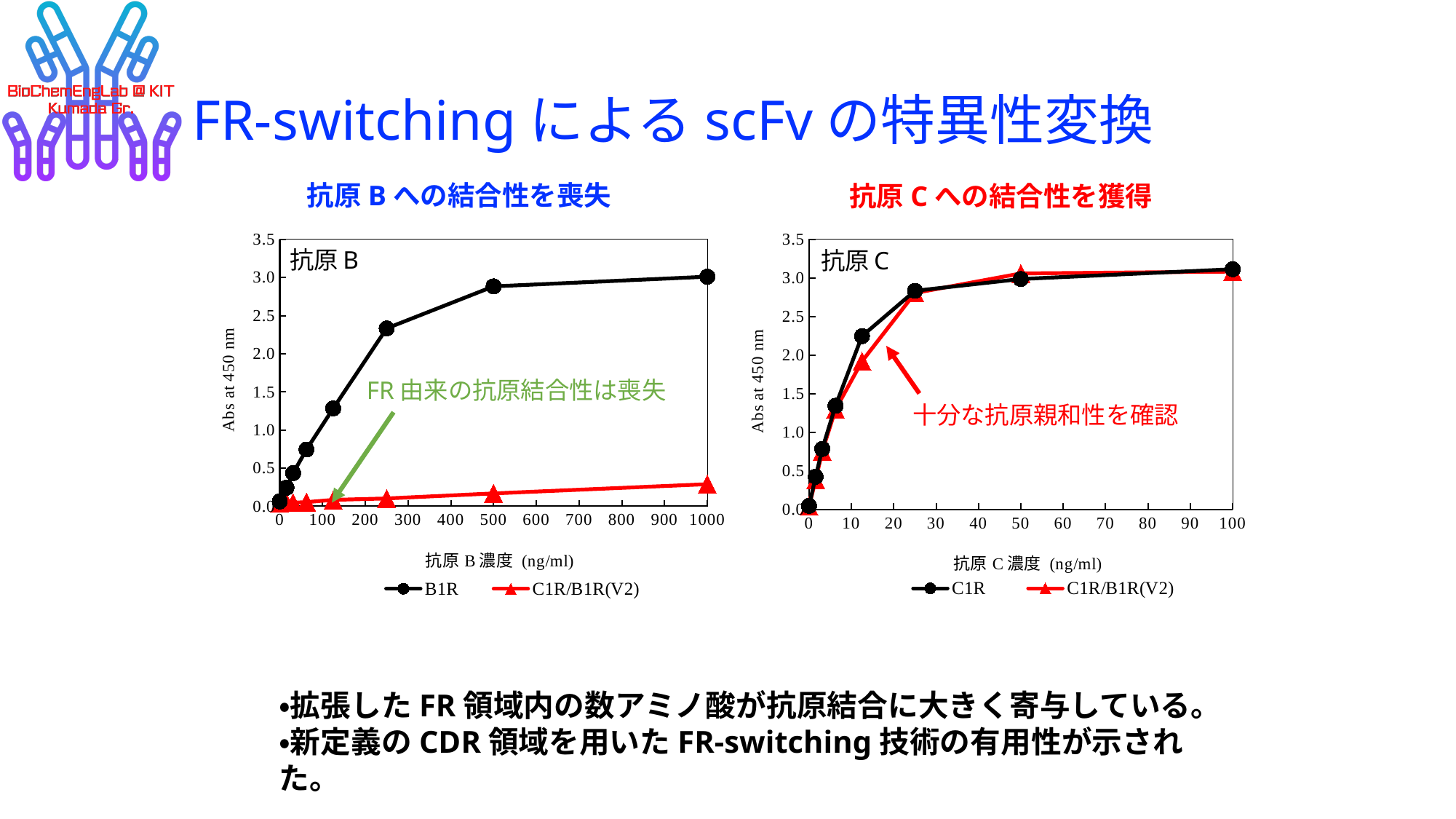
What are the two legend entries of the left chart (抗原 B)? B1R and C1R/B1R(V2) In the left chart (抗原 B), which series has the larger value at 1000 ng/ml, B1R or C1R/B1R(V2)? B1R In the left chart (抗原 B), is the value for B1R at 1000 ng/ml greater or less than 2.5? greater In the left chart (抗原 B), is the value for B1R at 250 ng/ml greater or less than 2.0? greater In the right chart (抗原 C), is the value for C1R/B1R(V2) at 12.5 ng/ml greater or less than 1.5? greater In the left chart (抗原 B), does the B1R series rise or fall as the antigen concentration increases? rise In the right chart (抗原 C), does the C1R/B1R(V2) series rise or fall as the antigen concentration increases? rise How many series does the legend of the right chart (抗原 C) list? 2 What kind of chart is the left chart titled 抗原 B? line chart What is the y-axis label of the left chart (抗原 B)? Abs at 450 nm